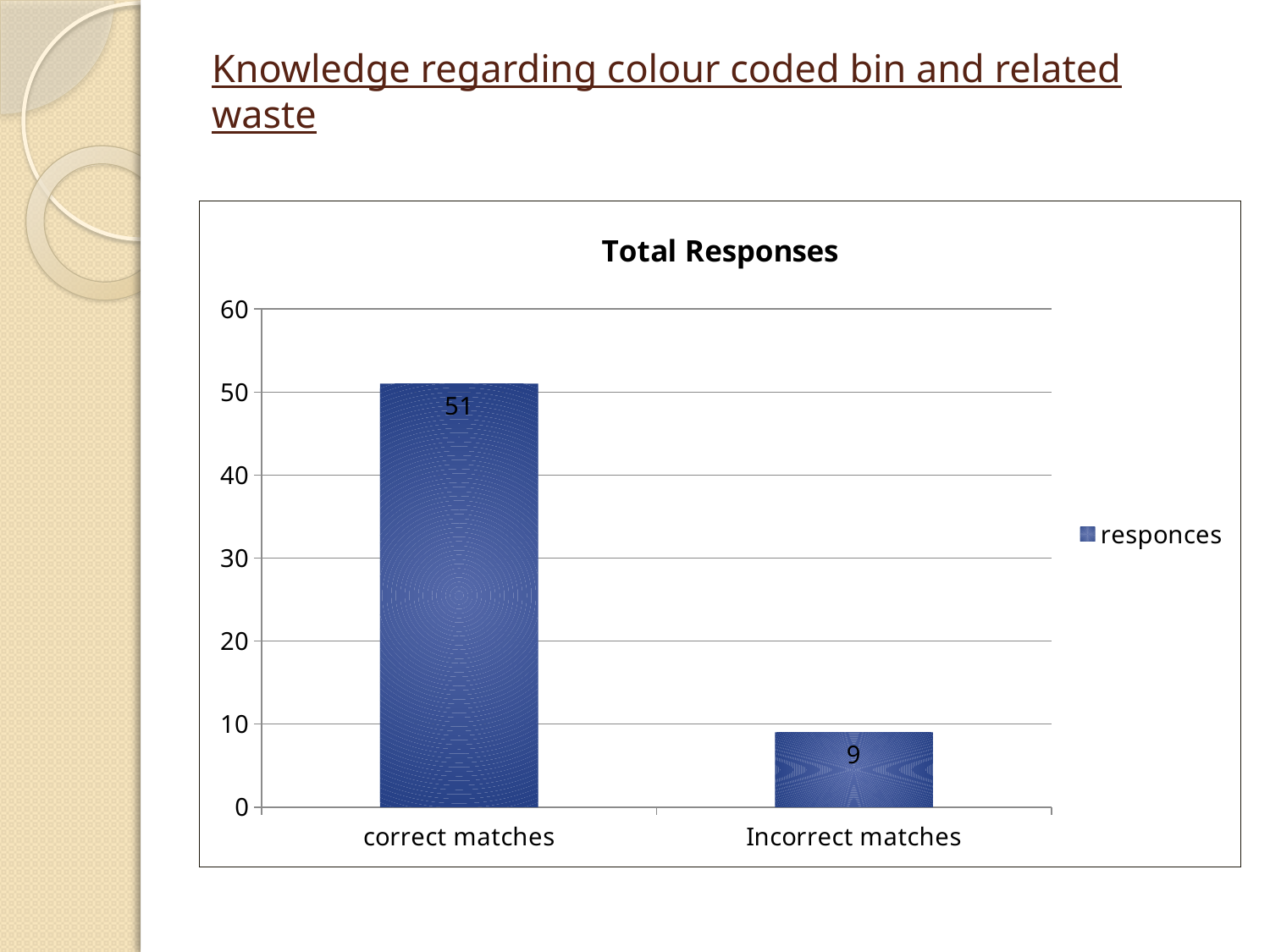
Which category has the highest value? correct matches What kind of chart is shown? bar chart Is the value for correct matches greater or less than 40? greater Is the value for Incorrect matches greater or less than 10? less What is the difference between the values for correct matches and Incorrect matches? 42 How many categories are shown on the x axis? 2 What is the title of the chart? Total Responses Which is larger, the value for correct matches or the value for Incorrect matches? correct matches What is the value for correct matches? 51 How many series does the legend list? 1 Which category has the lowest value? Incorrect matches What is the value for Incorrect matches? 9